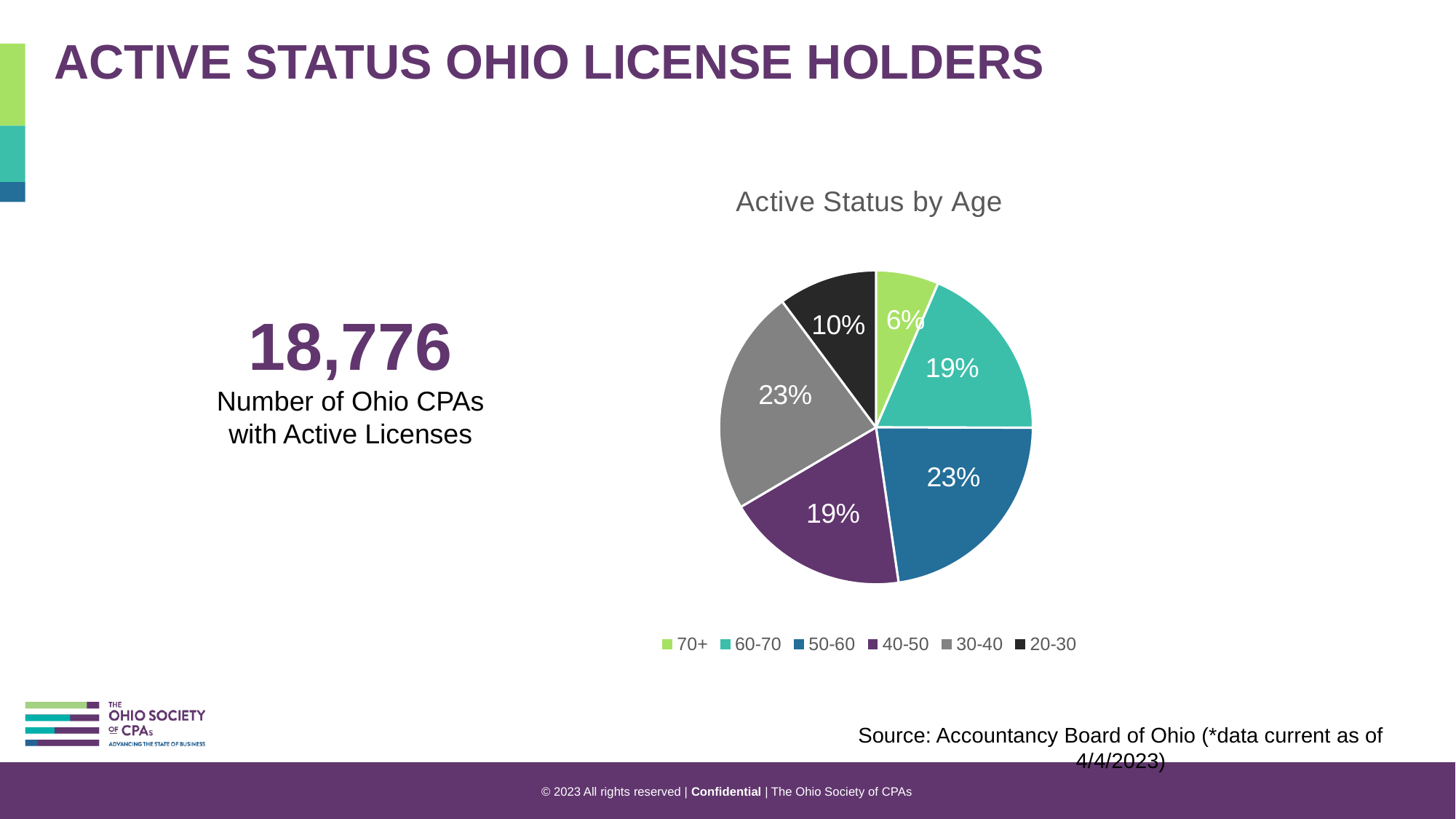
What is the difference in percentage points between the 50-60 slice and the 20-30 slice? 13 What colour is the slice for the 20-30 age group? Black What share of the pie does the 60-70 age group hold? 19% What share of the pie does the 30-40 age group hold? 23% What is the title of the chart? Active Status by Age Which age group has the smallest slice of the pie? 70+ How many age groups does the legend list? 6 What share of the pie does the 70+ age group hold? 6% What kind of chart is shown on the slide? Pie chart What share of the pie does the 20-30 age group hold? 10% Which slice is larger, 40-50 or 20-30? 40-50 What share of the pie does the 50-60 age group hold? 23%